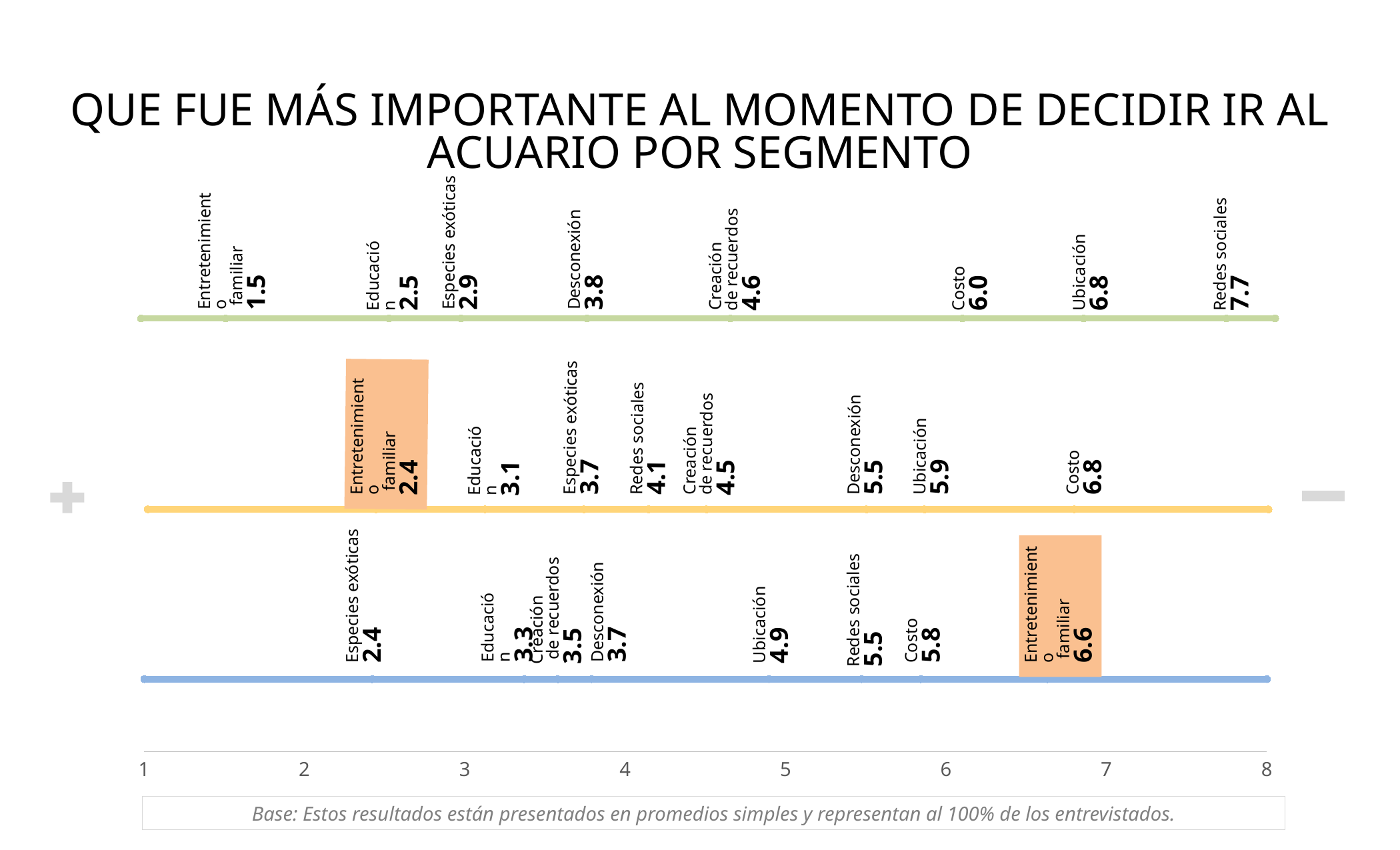
On the middle (yellow) line, what is the value for Costo? 6.8 On the bottom (blue) line, which is larger: the value for Costo or the value for Redes sociales? Costo On the bottom (blue) line, which category has the highest value? Entretenimiento familiar How many categories are plotted on the top (green) line? 8 On the middle (yellow) line, is the value for Desconexión greater or less than 5? greater On the middle (yellow) line, which category has the lowest value? Entretenimiento familiar On the top (green) line, which category has the lowest value? Entretenimiento familiar On the top (green) line, what is the value for Redes sociales? 7.7 On the bottom (blue) line, what is the value for Entretenimiento familiar? 6.6 What is the title of the chart? QUE FUE MÁS IMPORTANTE AL MOMENTO DE DECIDIR IR AL ACUARIO POR SEGMENTO How many horizontal lines (segments) does the chart show? 3 On the top (green) line, what is the difference between the values for Ubicación and Costo? 0.8